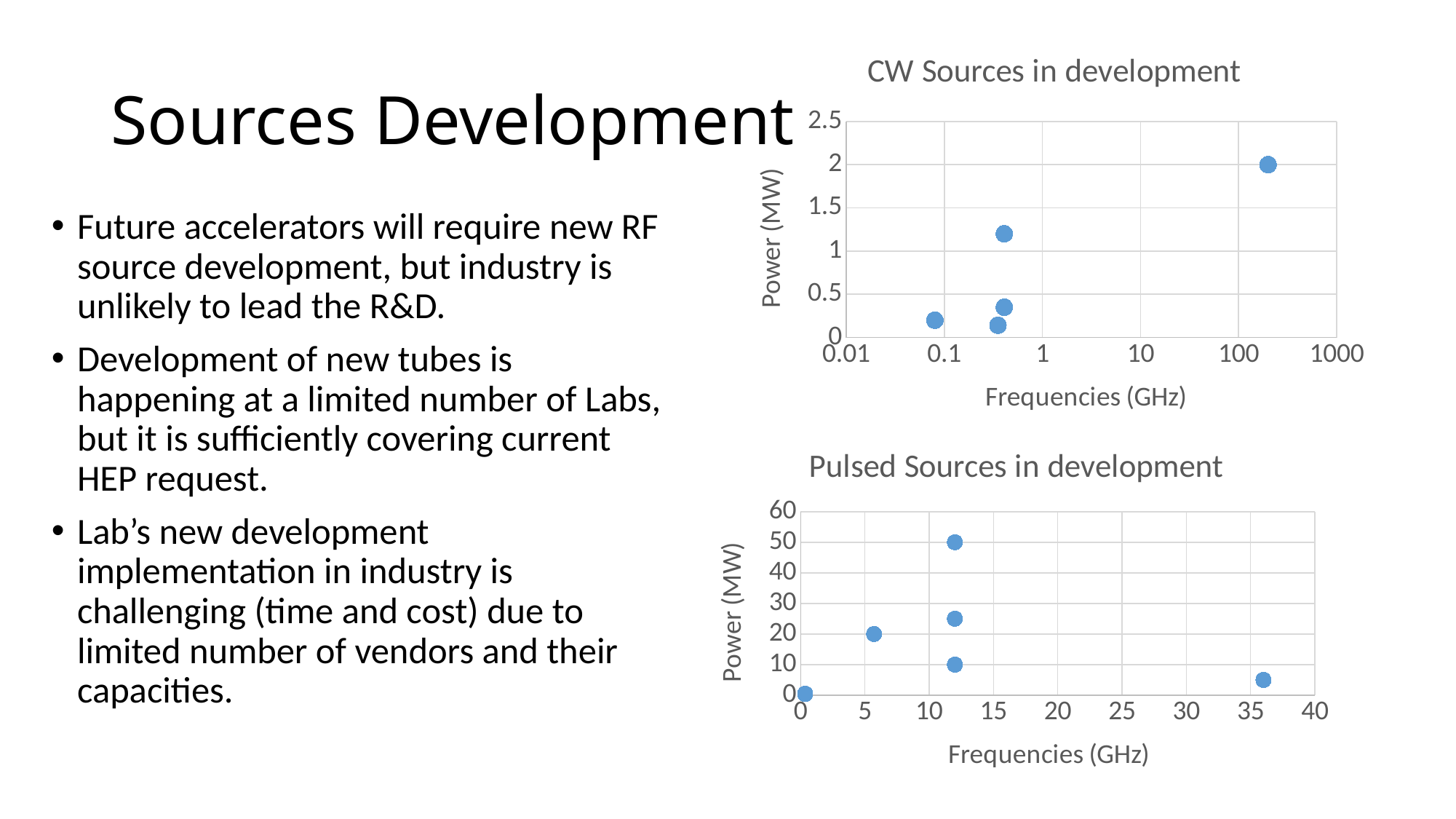
In the 'Pulsed Sources in development' chart, which has higher power: the point near 5 GHz or the point near 36 GHz? the point near 5 GHz In the 'Pulsed Sources in development' chart, is the power of the point near 36 GHz greater or less than 10 MW? less What is the y-axis label of the 'Pulsed Sources in development' chart? Power (MW) In the 'Pulsed Sources in development' chart, what is the power of the highest point? 50 How many data points are plotted in the 'CW Sources in development' chart? 5 In the 'CW Sources in development' chart, is the power of the point near 200 GHz greater or less than 1.5 MW? greater In the 'Pulsed Sources in development' chart, what is the maximum value shown on the y axis? 60 What is the x-axis label of the 'CW Sources in development' chart? Frequencies (GHz) In the 'CW Sources in development' chart, is the power of the point near 0.1 GHz greater or less than 0.5 MW? less In the 'CW Sources in development' chart, what is the power of the highest point, which lies at a frequency between 100 and 1000 GHz? 2 What kind of chart is the 'CW Sources in development' chart? scatter chart